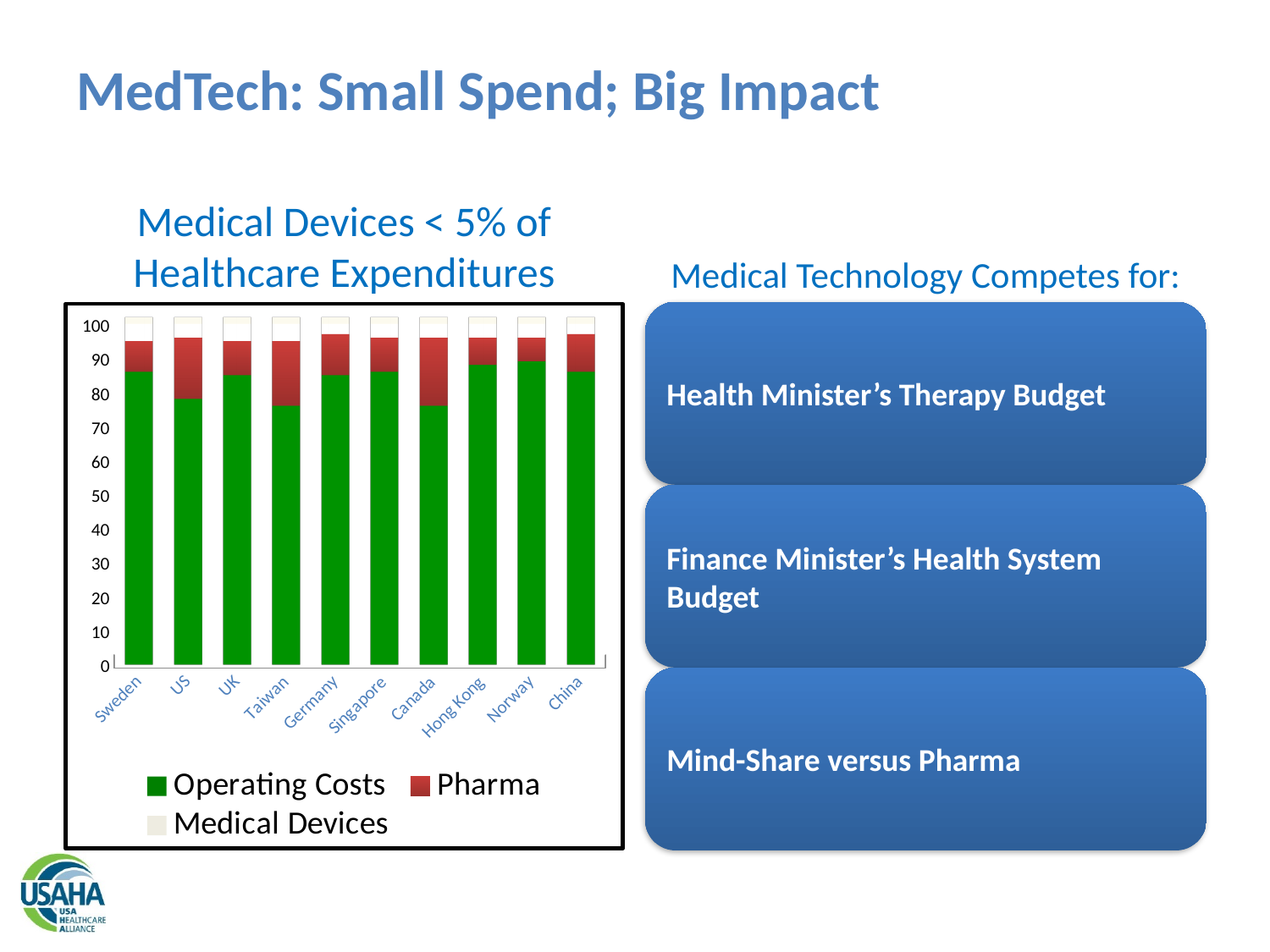
Which has the larger Operating Costs value, Germany or Taiwan? Germany Is the Operating Costs value for Germany greater or less than 80? greater What is the title of the chart? Medical Devices < 5% of Healthcare Expenditures How many countries are shown on the x axis of the chart? 10 How many series does the chart's legend list? 3 Which series is shown in green in the chart? Operating Costs What kind of chart is shown on the slide? bar chart Which has the larger Operating Costs value, Sweden or US? Sweden Is the Operating Costs value for Canada greater or less than 80? less What is the total height of the stacked bar for Sweden? 100 Is the Operating Costs value for Sweden greater or less than 80? greater